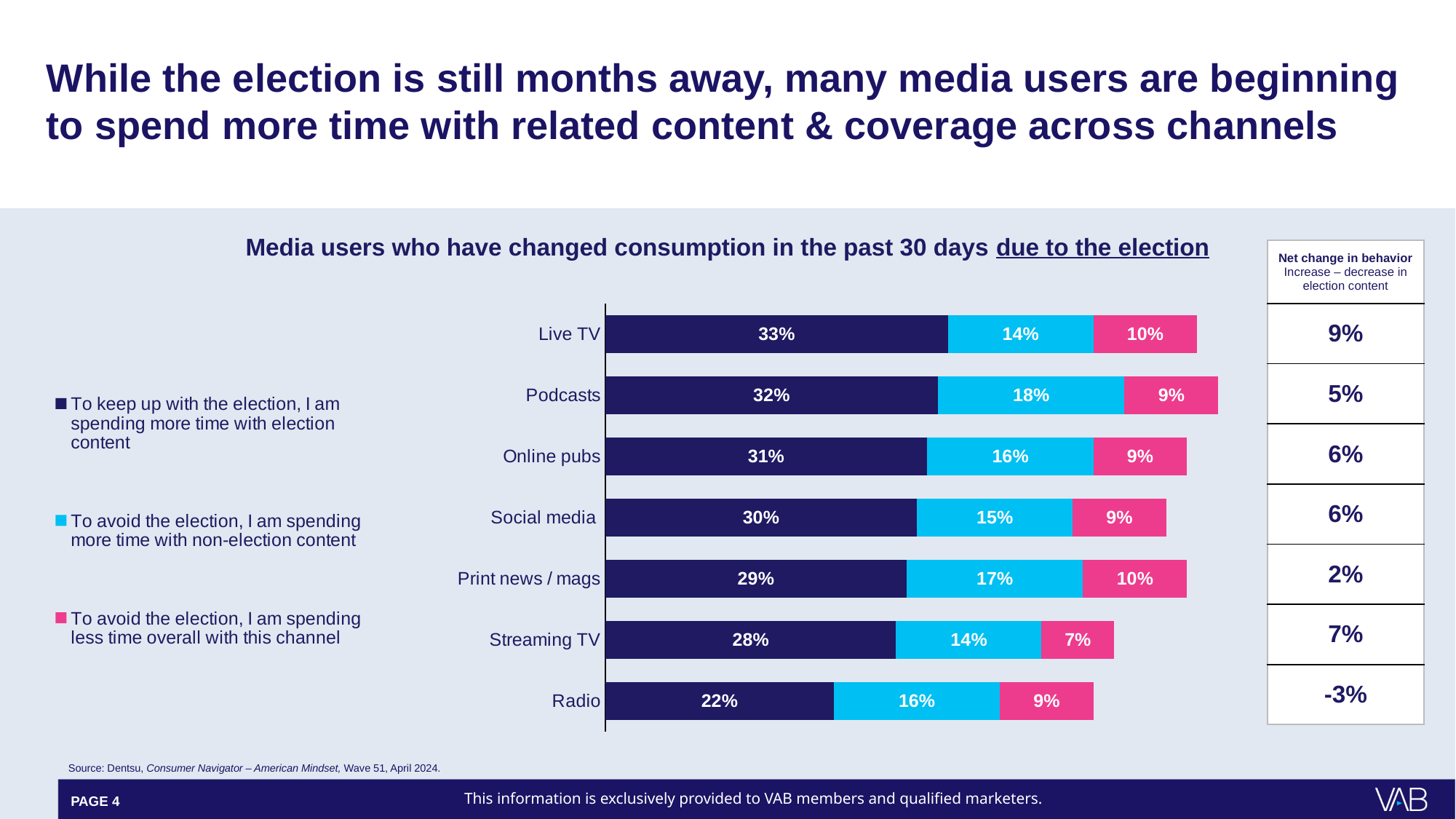
Which channel has the lowest share of users spending more time with election content to keep up with the election? Radio Which colour represents 'To avoid the election, I am spending less time overall with this channel' in the chart? Pink Which is larger: the share of Podcasts users or Social media users spending more time with non-election content to avoid the election? Podcasts What percentage of Live TV users say they are spending more time with election content to keep up with the election? 33% What kind of chart is shown on the slide? Stacked bar chart How many series does the legend list? 3 What is the total of the stacked bar for Radio? 47% What percentage of Streaming TV users say they are spending less time overall with this channel to avoid the election? 7% How many channels are shown in the chart? 7 What is the difference between the share of Live TV users and Radio users who are spending more time with election content? 11% What percentage of Podcasts users say they are spending more time with non-election content to avoid the election? 18% Which channel has the highest share of users spending more time with election content to keep up with the election? Live TV